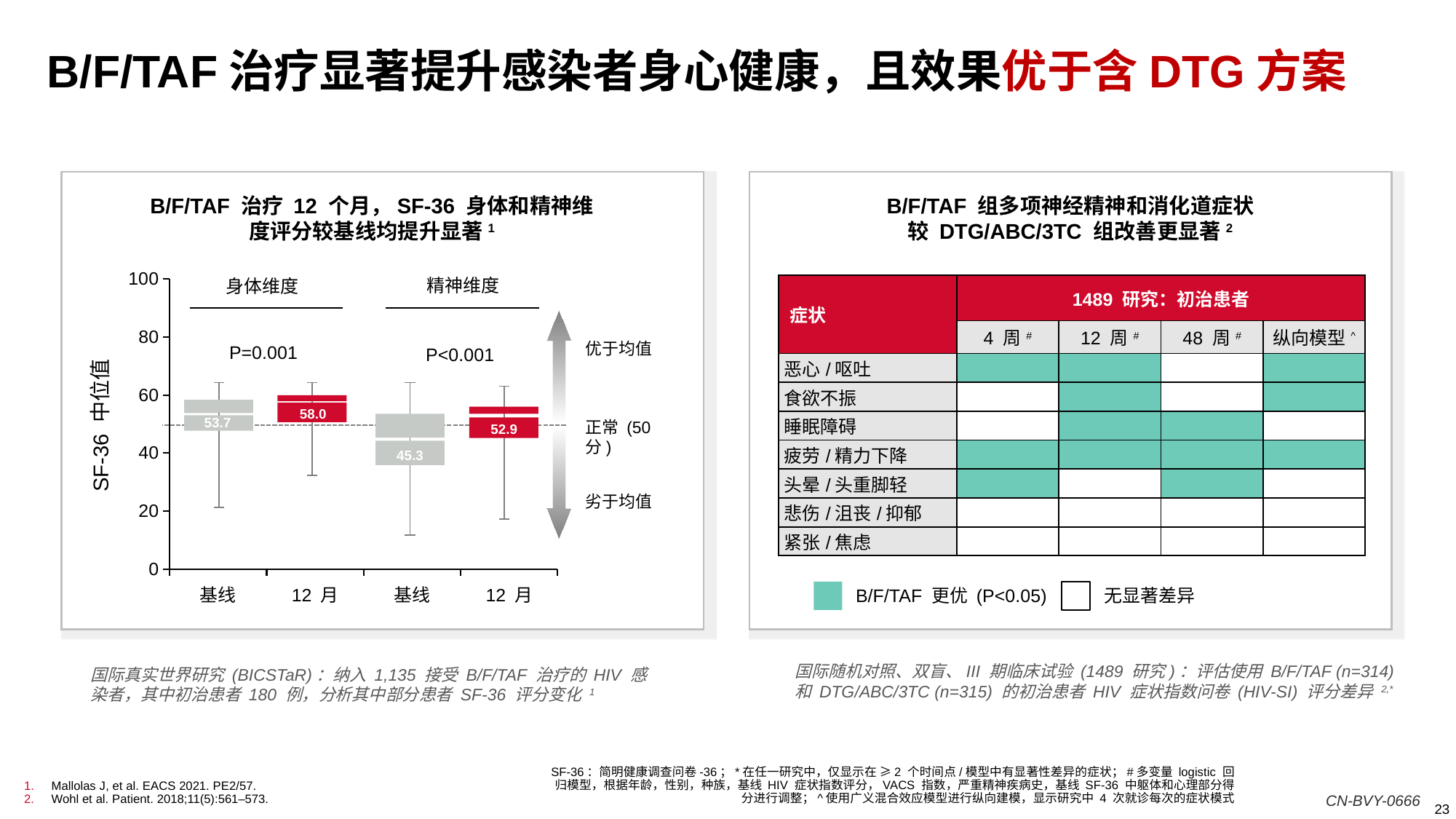
In the left chart, by how much did the 精神维度 median increase from 基线 to 12 月? 7.6 In the left chart, what is the median SF-36 score for 身体维度 at 12 月? 58.0 What kind of chart is shown on the left of the slide? box plot In the left chart, is the 精神维度 基线 median greater or less than 50? less In the left chart, what is the median SF-36 score for 精神维度 at 12 月? 52.9 In the left chart, which box has the highest median value? 身体维度 12 月 (58.0) In the left chart, by how much did the 身体维度 median increase from 基线 to 12 月? 4.3 In the left chart, what P value is shown for the 精神维度 comparison? P<0.001 In the left chart, which box has the lowest median value? 精神维度 基线 (45.3) In the left chart, what is the median SF-36 score for 精神维度 at 基线? 45.3 In the left chart, what is the median SF-36 score for 身体维度 at 基线? 53.7 In the left chart, which is larger: the 基线 median for 身体维度 or the 基线 median for 精神维度? 身体维度 基线